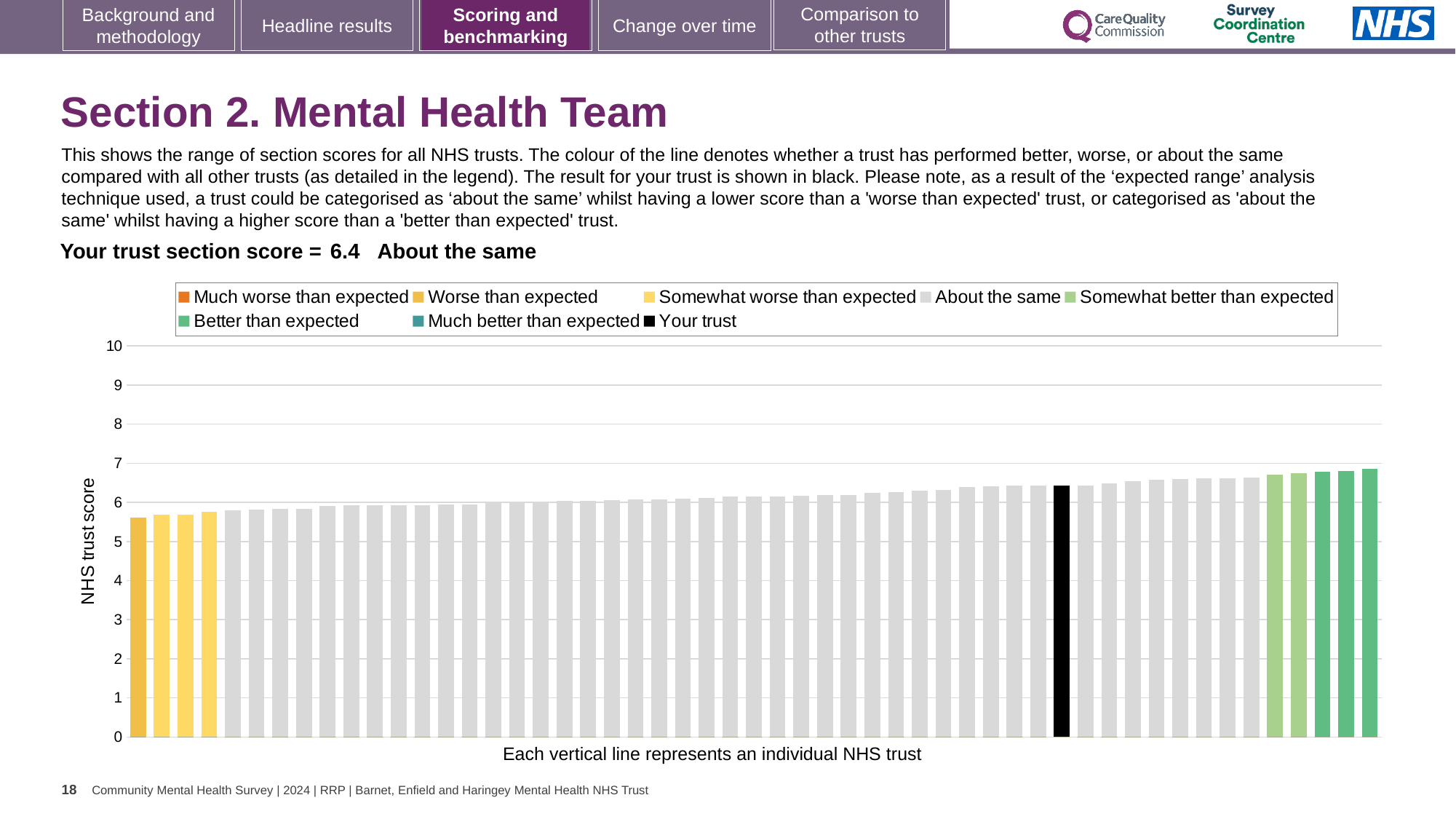
Is the value of the lowest bar in the chart greater or less than 5? greater Is the value of the black bar (your trust) greater or less than 6? greater Which is larger: the value of the black bar (your trust) or the value of the leftmost bar? the black bar (your trust) Is the value of the black bar (your trust) greater or less than 7? less Do the bar values rise or fall from left to right across the chart? rise What kind of chart is shown on the slide? bar chart What is the section score for your trust shown on the slide? 6.4 According to the slide, which performance category does your trust fall into? About the same What is the label on the vertical axis of the chart? NHS trust score How many entries does the chart legend list? 8